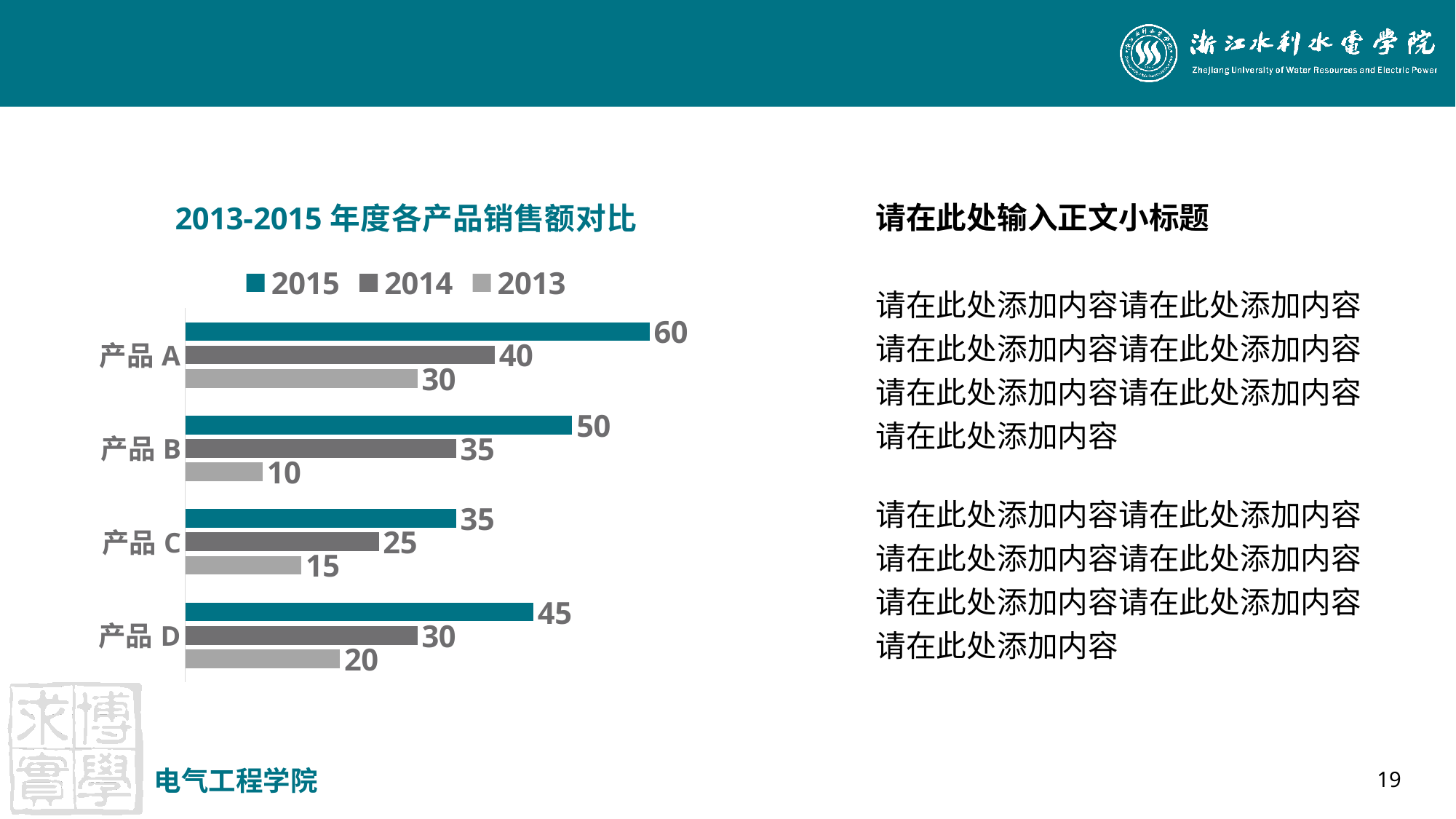
What is the 2013 value for 产品 B? 10 Which product has the lowest 2013 value? 产品 B What is the 2014 value for 产品 C? 25 What kind of chart is shown on the slide? Bar chart Which product has the highest 2015 value? 产品 A How many products are shown on the chart? 4 How many series does the legend list? 3 Which series is shown in teal in the legend? 2015 What is the difference between the 2015 and 2014 values for 产品 D? 15 Which is larger: the 2014 value for 产品 B or the 2014 value for 产品 D? 2014 value for 产品 B What is the title of the chart? 2013-2015 年度各产品销售额对比 What is the 2015 value for 产品 A? 60